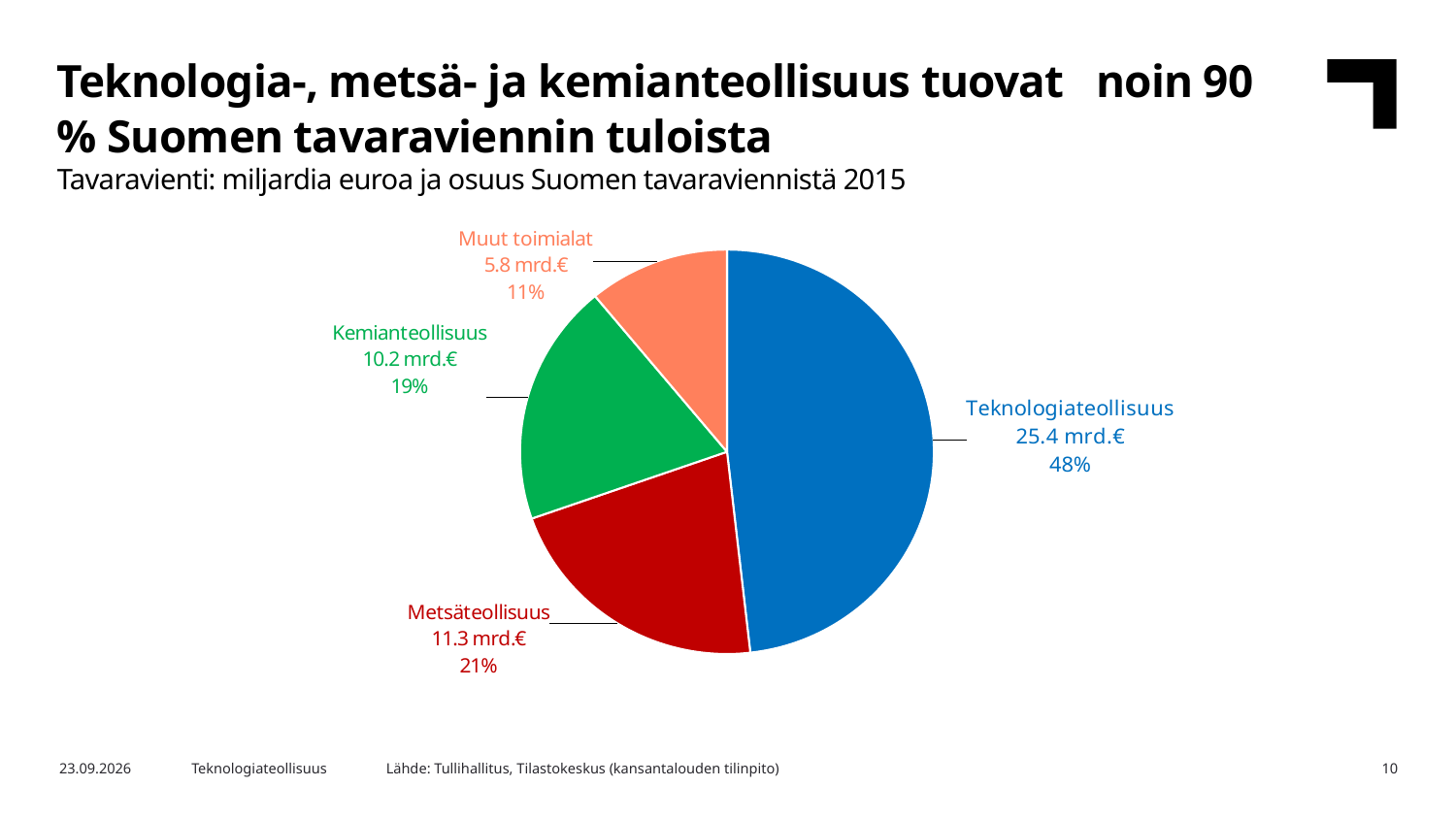
What share of the pie does Teknologiateollisuus represent? 48% What share of the pie does Kemianteollisuus represent? 19% What is the value for Metsäteollisuus? 11.3 mrd.€ What kind of chart is shown on the slide? Pie chart What is the value for Kemianteollisuus? 10.2 mrd.€ What is the value for Teknologiateollisuus? 25.4 mrd.€ What is the difference in value between Teknologiateollisuus and Metsäteollisuus? 14.1 mrd.€ How many slices does the pie chart have? 4 Which is larger, Metsäteollisuus or Kemianteollisuus? Metsäteollisuus Which slice is the smallest? Muut toimialat What is the value for Muut toimialat? 5.8 mrd.€ Which slice is the largest? Teknologiateollisuus